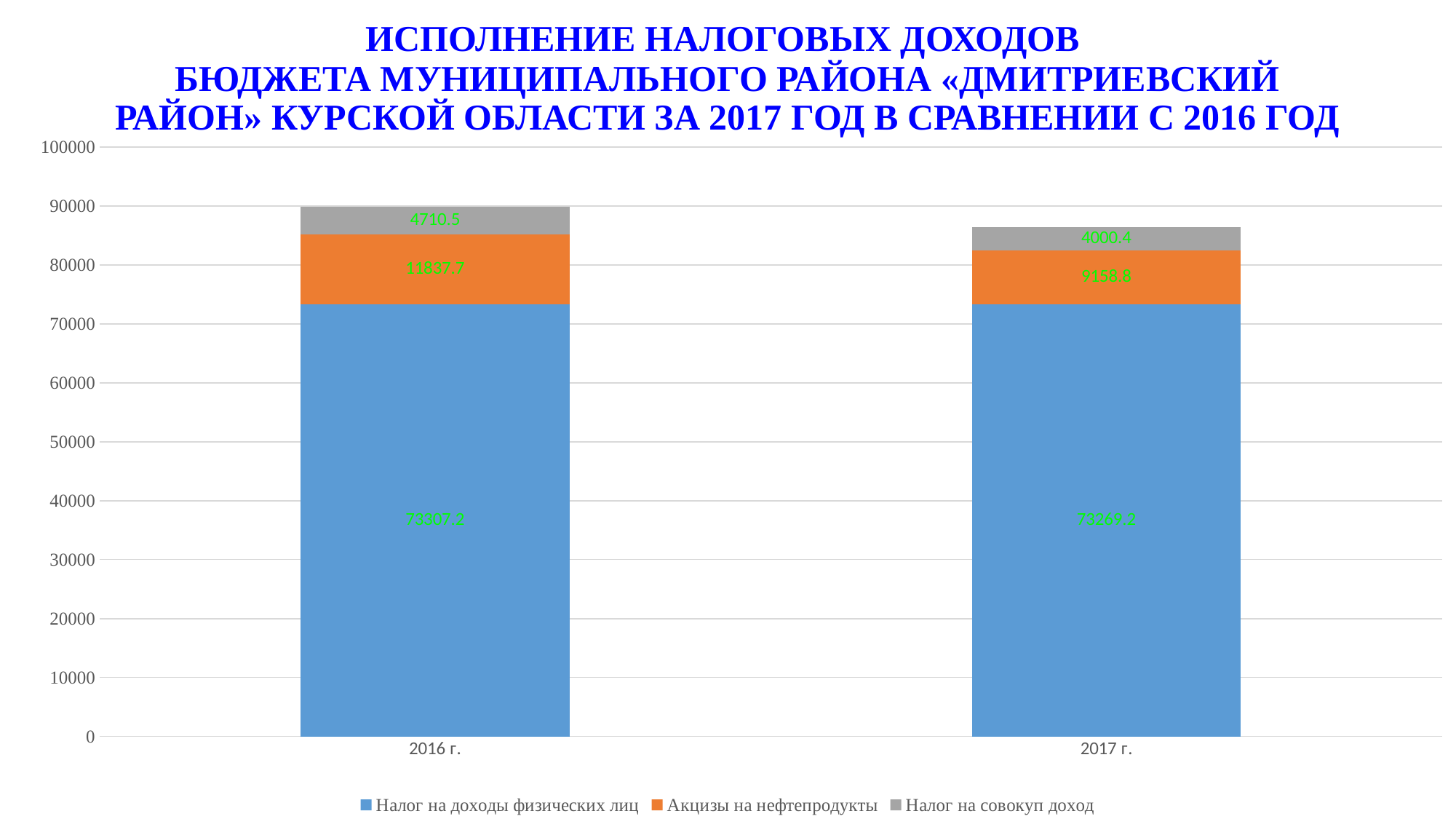
How many series does the legend list? 3 What is the difference between Акцизы на нефтепродукты in 2016 г. and 2017 г.? 2678.9 What is the value of Акцизы на нефтепродукты for 2017 г.? 9158.8 What is the value of Налог на совокуп доход for 2017 г.? 4000.4 What is the value of Налог на совокуп доход for 2016 г.? 4710.5 What is the total of the stacked bar for 2017 г.? 86428.4 Which year has the larger value for Акцизы на нефтепродукты, 2016 г. or 2017 г.? 2016 г. What is the difference between Налог на совокуп доход in 2016 г. and 2017 г.? 710.1 How many categories are shown on the x axis? 2 What is the value of Налог на доходы физических лиц for 2016 г.? 73307.2 Which colour represents Налог на совокуп доход in the legend? Gray What type of chart is shown on the slide? Stacked bar chart